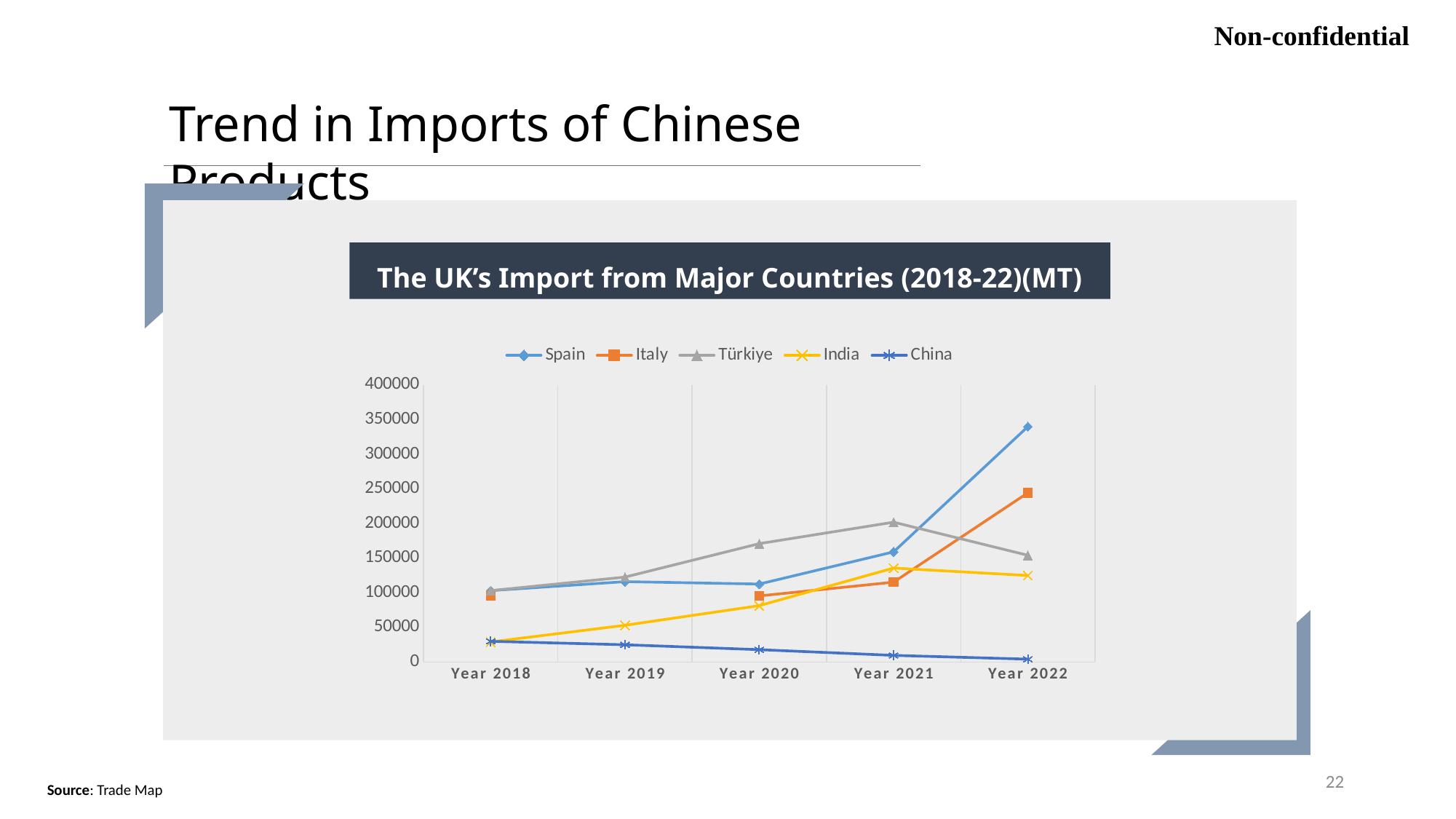
Is the value for India in Year 2019 greater or less than 100000? less How many years are shown along the x axis of the chart? 5 How many series does the legend of the chart list? 5 Which country has the lowest import value in Year 2022? China Do the values for China rise or fall from Year 2018 to Year 2022? fall Is the value for Türkiye in Year 2021 greater or less than 150000? greater Which country has the highest import value in Year 2021? Türkiye In Year 2020, which is larger: the value for Türkiye or the value for Spain? Türkiye What kind of chart is shown on the slide? line chart Is the value for Spain in Year 2022 greater or less than 300000? greater What is the title of the chart? The UK's Import from Major Countries (2018-22)(MT) Which country has the highest import value in Year 2022? Spain